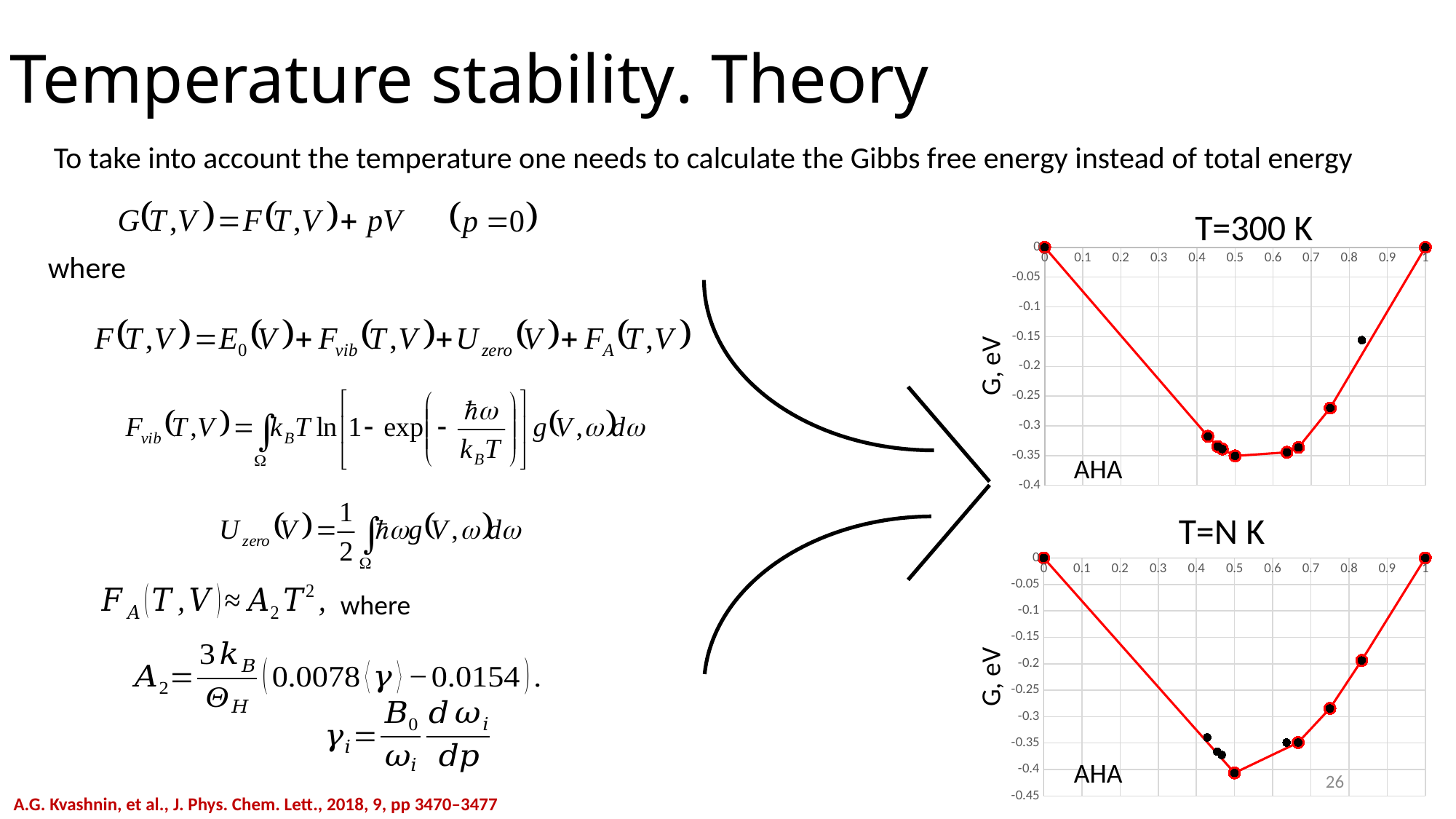
What is the y-axis label of the T=300 K chart? G, eV In the T=300 K chart, what is the value of G at x = 0? 0 In the T=N K chart, is the value at x = 0.75 greater or less than -0.2? less In the T=300 K chart, is the value at x = 0.5 greater or less than -0.3? less In the T=300 K chart, is the value at x = 0.5 greater or less than -0.4? greater In the T=N K chart, what is the value of G at x = 1? 0 What kind of chart is the T=300 K chart? line chart with markers In the T=N K chart, does G rise or fall as x goes from 0 to 0.5? fall What is the title of the lower chart on the slide? T=N K In the T=300 K chart, which is larger: the value at x = 0.5 or the value at x = 0.75? the value at x = 0.75